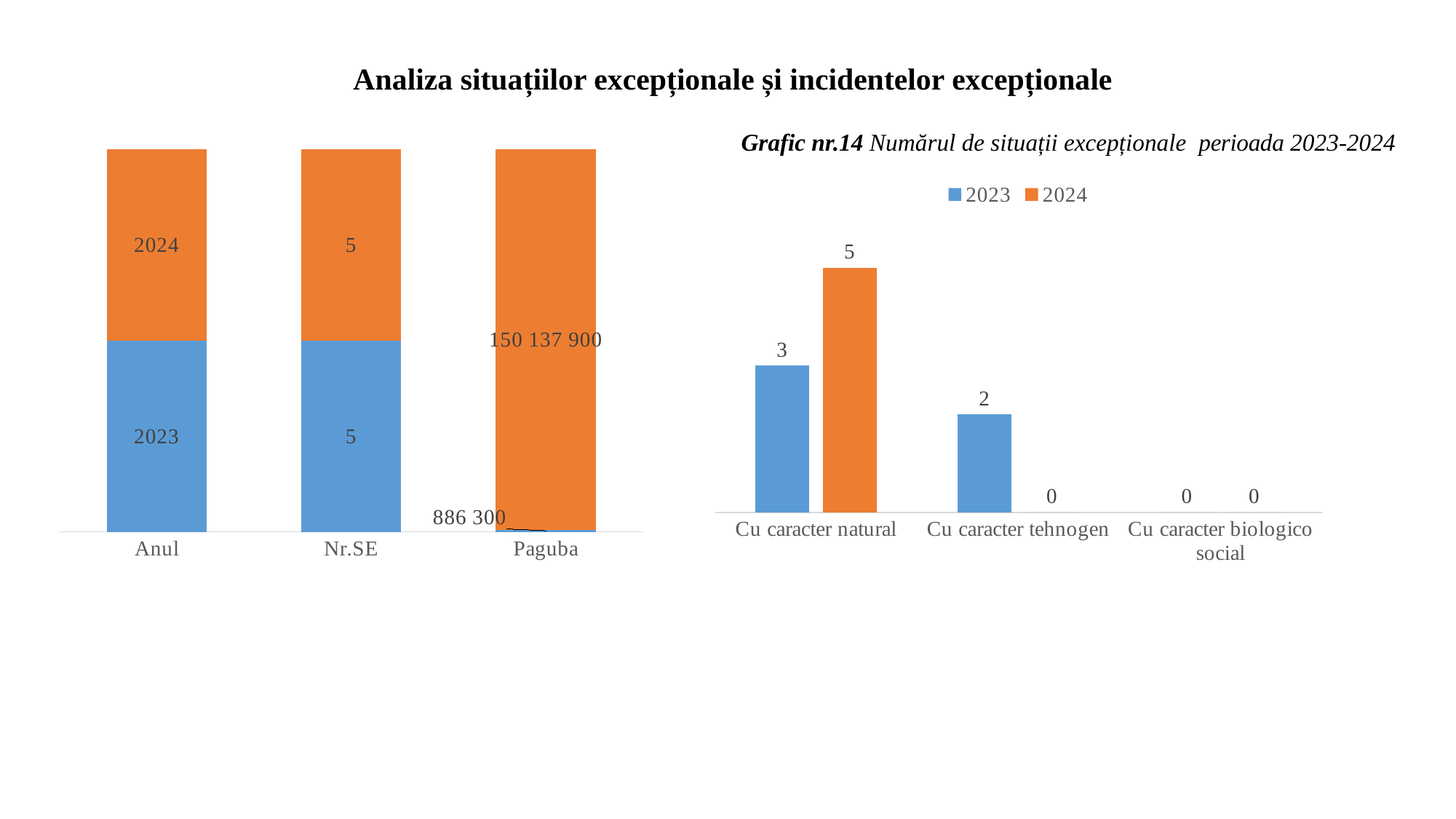
In the chart titled 'Grafic nr.14', what is the value for 2023 in the 'Cu caracter natural' category? 3 What kind of chart is the chart on the left side of the slide? Stacked bar chart In the chart on the left side of the slide, what is the value of the blue (2023) segment for 'Paguba'? 886 300 In the chart titled 'Grafic nr.14', what is the value for 2023 in the 'Cu caracter tehnogen' category? 2 In the chart titled 'Grafic nr.14', how many categories are shown on the x axis? 3 In the chart titled 'Grafic nr.14', what is the value for 2024 in the 'Cu caracter biologico social' category? 0 In the chart titled 'Grafic nr.14', what is the difference between the 2024 and 2023 values for 'Cu caracter natural'? 2 In the chart titled 'Grafic nr.14', what is the value for 2024 in the 'Cu caracter natural' category? 5 In the chart titled 'Grafic nr.14', how many series does the legend list? 2 In the chart titled 'Grafic nr.14', which category has the highest value for 2023? Cu caracter natural In the chart on the left side of the slide, what is the value of the orange (2024) segment for 'Paguba'? 150 137 900 In the chart titled 'Grafic nr.14', which is larger for 'Cu caracter tehnogen': the 2023 value or the 2024 value? 2023